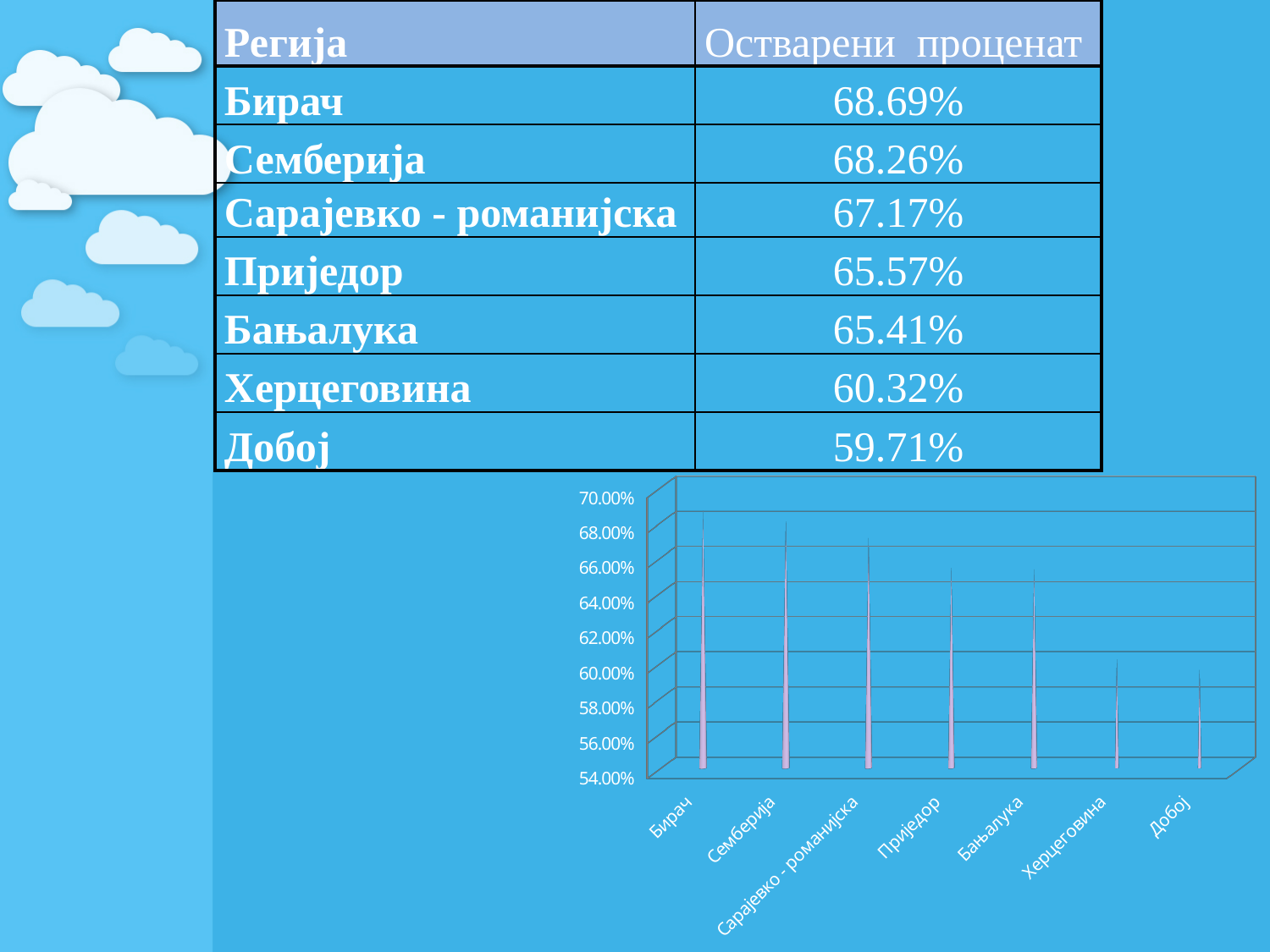
Which region has the highest achieved percentage? Бирач What is the achieved percentage for Херцеговина? 60.32% What is the achieved percentage for Приједор? 65.57% What kind of chart is shown on the slide? bar chart In the chart, is the value for Херцеговина greater or less than 62.00%? less What is the difference between the achieved percentages of Бирач and Добој? 8.98% Which region has the lowest achieved percentage? Добој How many regions are shown in the chart? 7 What is the achieved percentage (Остварени проценат) for Бирач? 68.69% Which has a higher achieved percentage, Семберија or Херцеговина? Семберија In the chart, is the value for Бирач greater or less than 66.00%? greater Do the values in the chart rise or fall from left to right along the x axis? fall